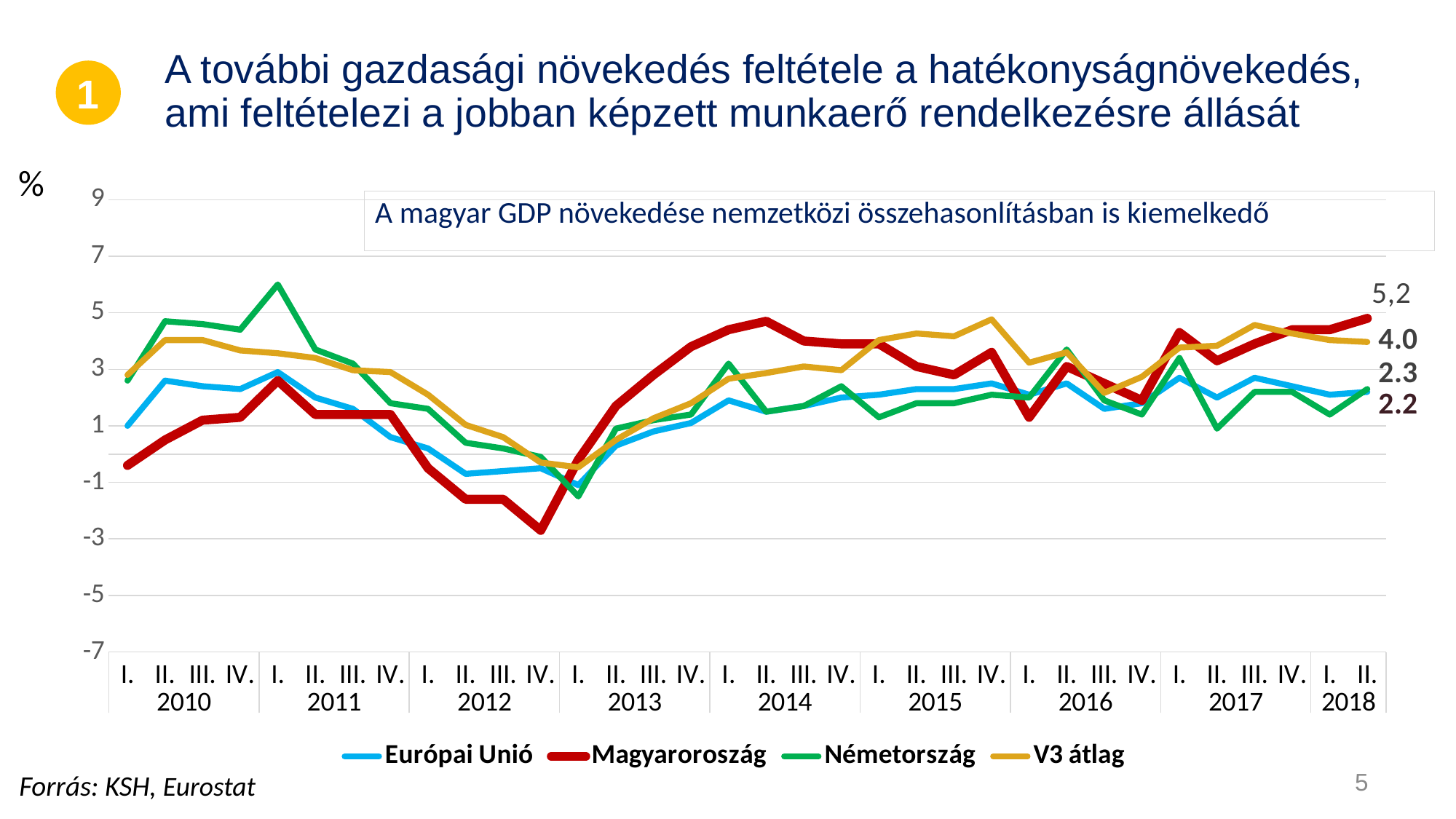
What is the value labelled for V3 átlag at the last point (2018 II.)? 4.0 Is the value for Magyarország in 2012 IV. greater or less than -1? less In which quarter does the Magyarország series reach its lowest value? 2012 IV. What is the text in the box at the top of the chart? A magyar GDP növekedése nemzetközi összehasonlításban is kiemelkedő How many years are shown on the x axis? 9 What is the value labelled for Magyarország at the last point (2018 II.)? 5,2 How many series does the legend list? 4 What kind of chart is shown on the slide? line chart What is the value labelled for Németország at the last point (2018 II.)? 2.3 Is the value for Németország in 2011 I. greater or less than 5? greater Which series has the highest value at the last point (2018 II.)? Magyarország What is the value labelled for Európai Unió at the last point (2018 II.)? 2.2